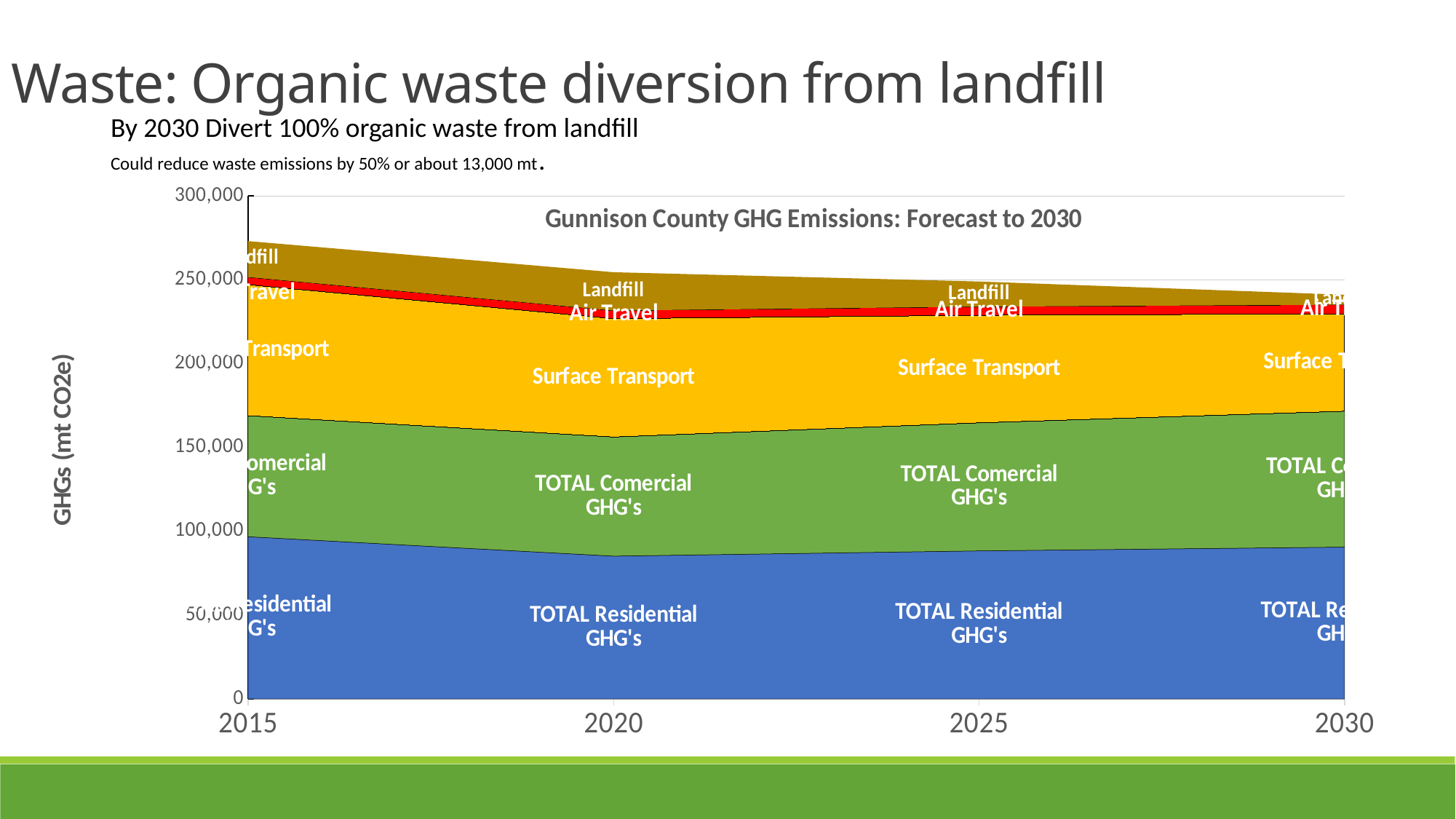
What is the label of the y axis? GHGs (mt CO2e) Which category is larger in 2020, Surface Transport or Air Travel? Surface Transport How many years are marked on the x axis of the chart? 4 Is the total stacked emissions value in 2015 greater or less than 250,000? greater How many emission categories are stacked in the chart? 5 Which category occupies the thinnest band in the stacked chart? Air Travel What is the title of the chart? Gunnison County GHG Emissions: Forecast to 2030 Is the total stacked emissions value in 2030 greater or less than 250,000? less What kind of chart is shown on the slide? Stacked area chart Which category is plotted at the bottom of the stack? TOTAL Residential GHG's Does the total stacked emissions value rise or fall from 2015 to 2030? Fall Is the value for TOTAL Residential GHG's in 2020 greater or less than 100,000? less